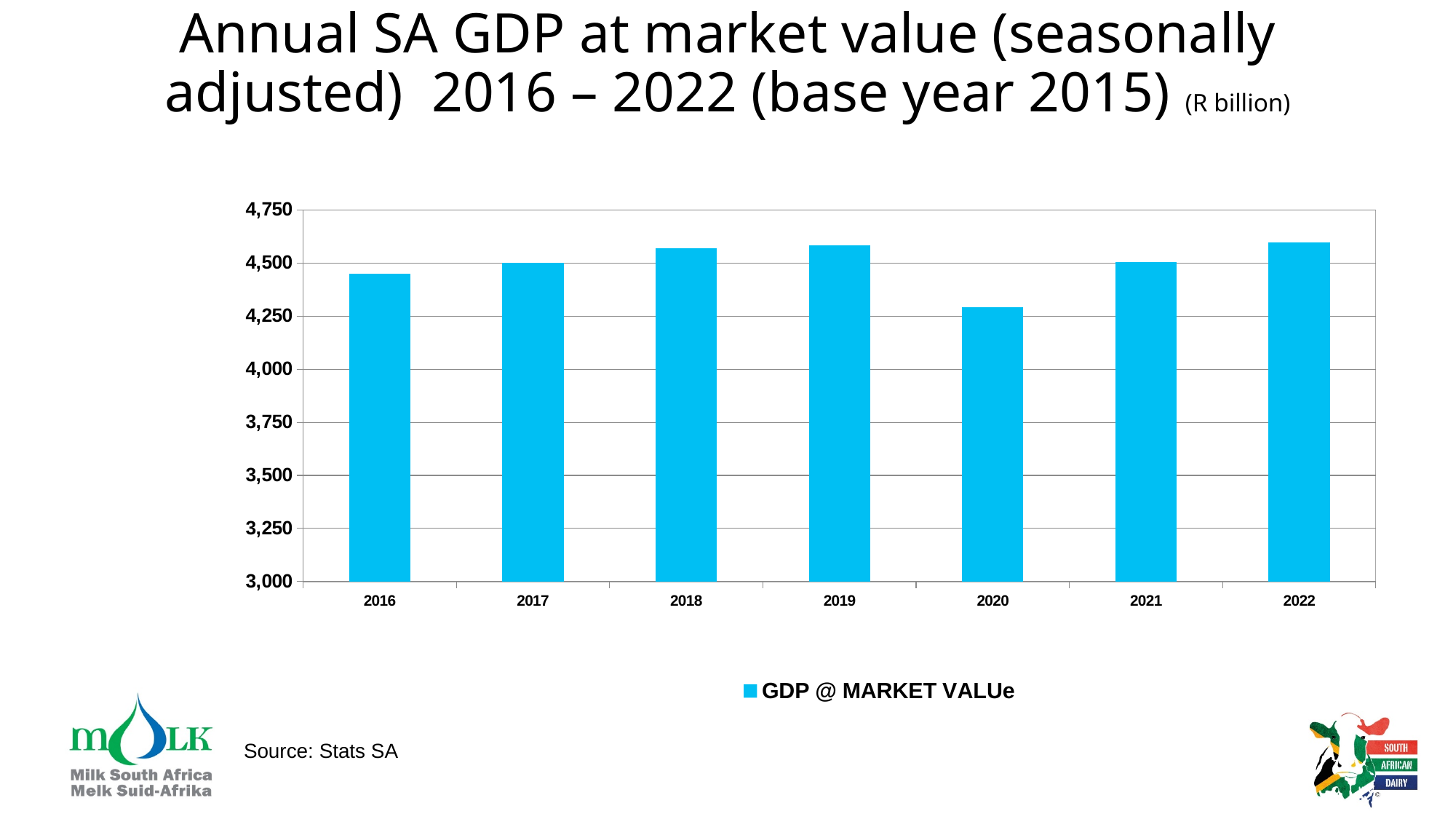
What kind of chart is shown on the slide? bar chart Is the value for 2018 greater or less than 4,500? greater Which year has the lowest GDP at market value? 2020 Is the value for 2020 greater or less than 4,250? greater Did the GDP at market value rise or fall from 2019 to 2020? fall Is the value for 2020 greater or less than 4,500? less How many years are plotted on the chart? 7 Which is larger, the value for 2016 or the value for 2018? 2018 How many series does the legend list? 1 Which is larger, the value for 2019 or the value for 2020? 2019 What is the legend entry for the plotted series? GDP @ MARKET VALUe